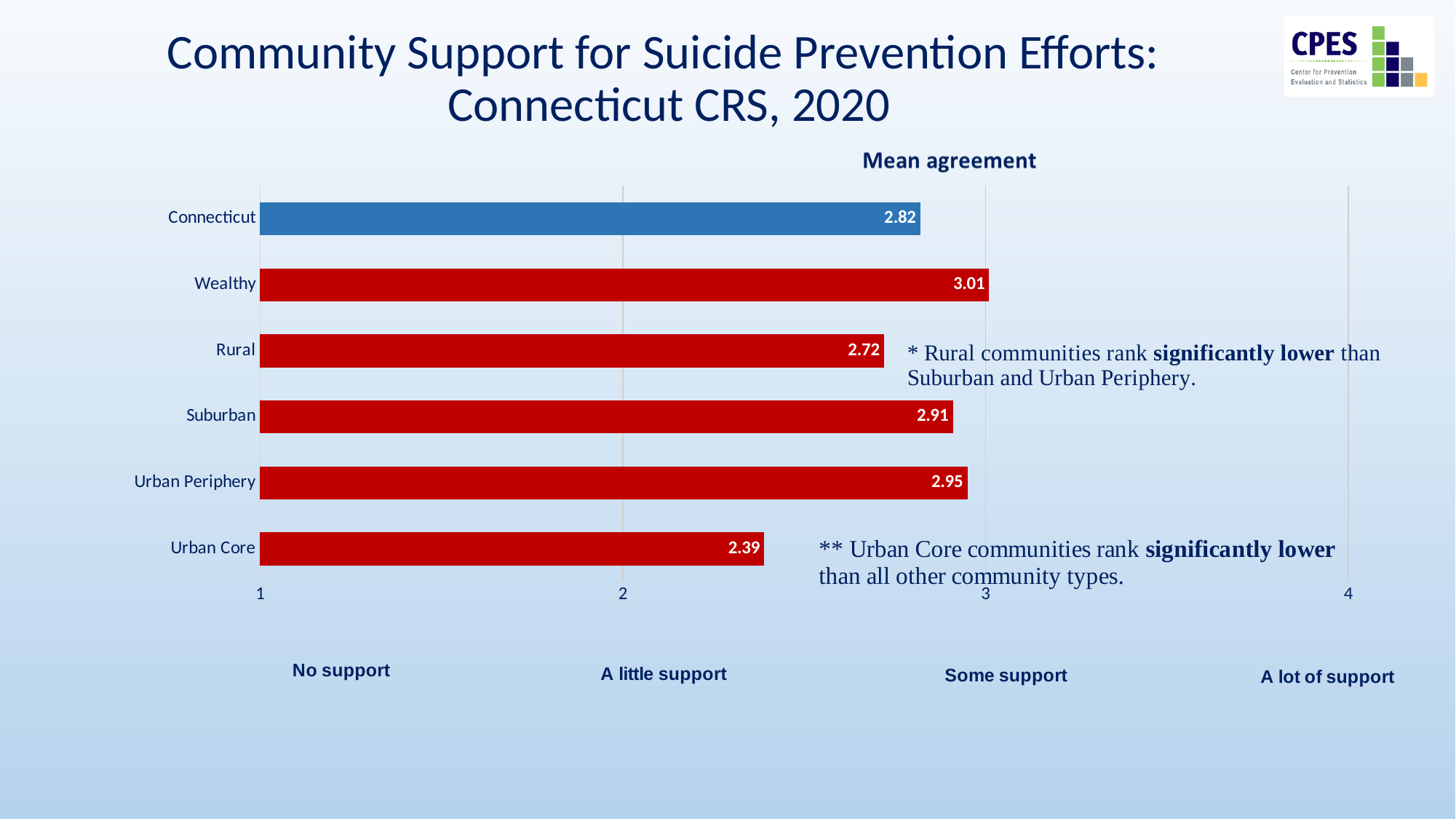
What kind of chart is shown on the slide? Bar chart What is the mean agreement value for Wealthy communities? 3.01 Which category has the highest mean agreement? Wealthy What is the mean agreement value for Connecticut? 2.82 What is the mean agreement value for Rural communities? 2.72 What is the title shown above the chart's plot area? Mean agreement Is the mean agreement for Wealthy communities greater or less than 3? greater How many categories are shown in the chart? 6 Which has a higher mean agreement, Suburban or Urban Periphery? Urban Periphery What is the difference between the mean agreement for Wealthy and Urban Core communities? 0.62 Which category has the lowest mean agreement? Urban Core What is the mean agreement value for Urban Core communities? 2.39